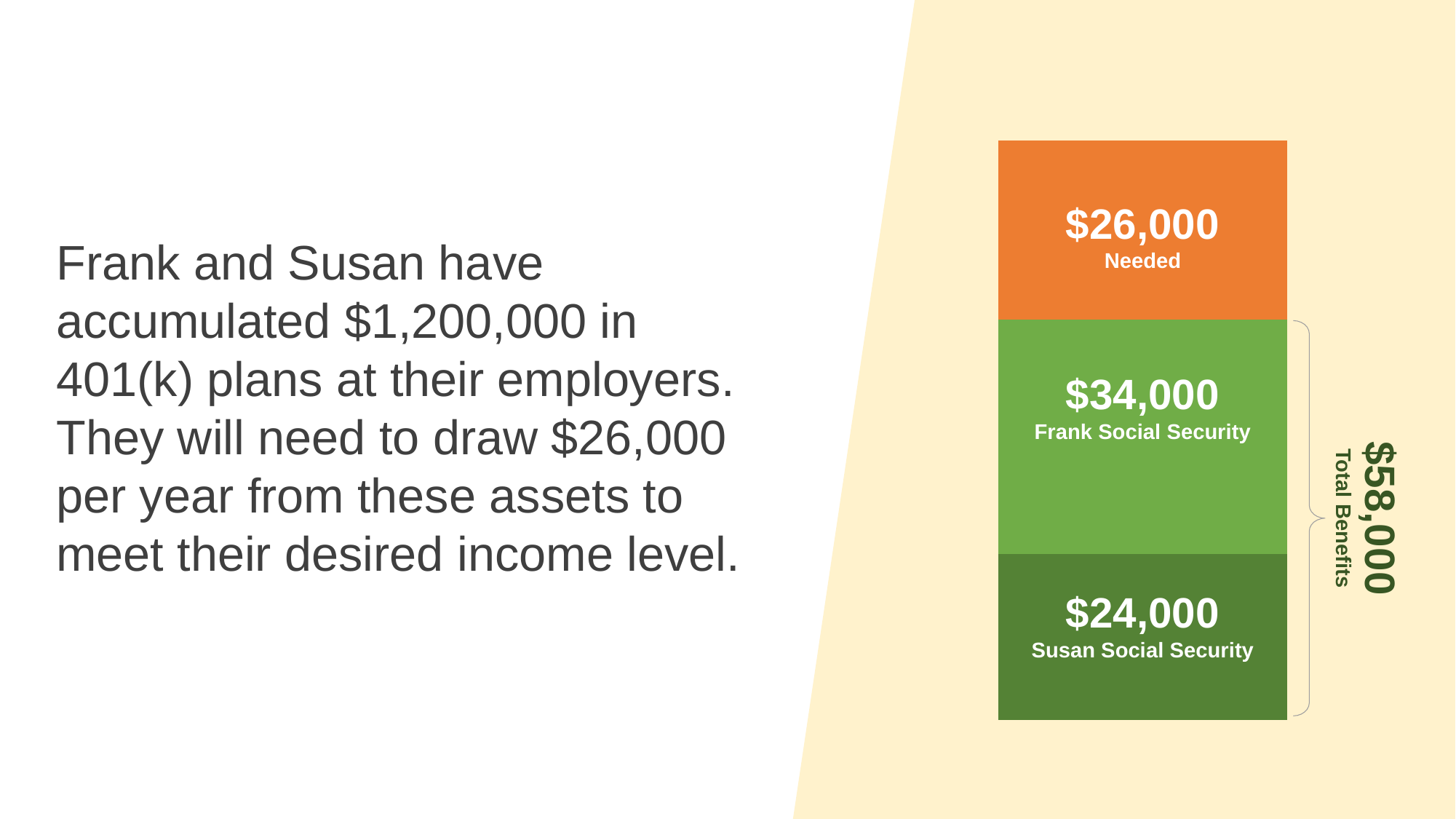
What is the difference between Frank Social Security and the Needed amount? $8,000 How many segments make up the stacked bar? 3 What value is shown for the Needed segment of the stacked bar? $26,000 What total is labelled for the two Social Security segments combined? $58,000 Which segment of the stacked bar has the largest value? Frank Social Security Which is larger, the Needed amount or Susan Social Security? Needed What colour is the Needed segment of the stacked bar? Orange What is the difference between Frank Social Security and Susan Social Security? $10,000 What is the total of all three segments in the stacked bar? $84,000 Which segment of the stacked bar has the smallest value? Susan Social Security What value is shown for Susan Social Security? $24,000 What value is shown for Frank Social Security? $34,000